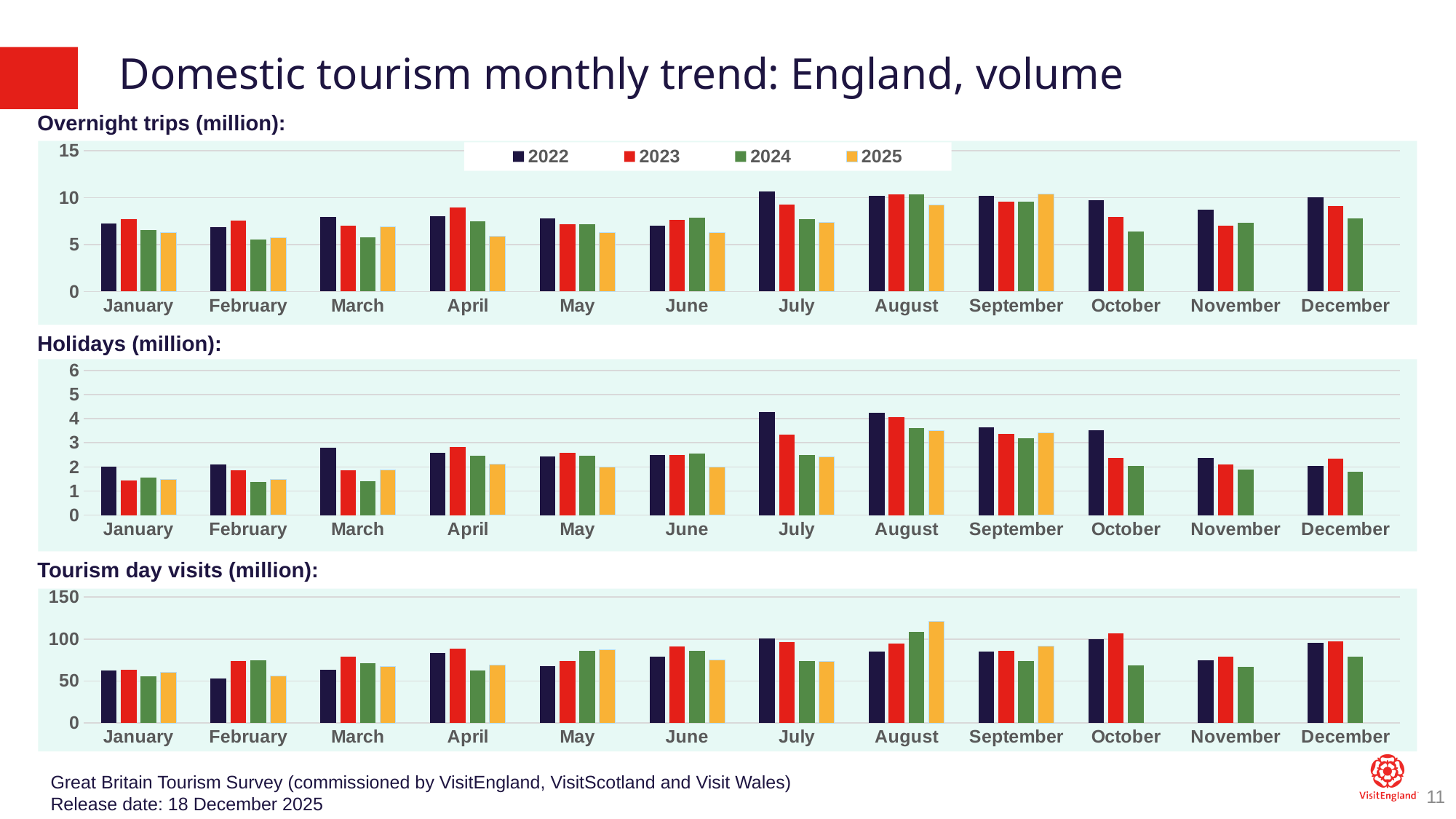
What kind of chart is the 'Overnight trips (million)' chart? bar chart In the 'Holidays (million)' chart, is the value for January 2023 greater or less than 2? less How many months are shown on the x axis of the 'Tourism day visits (million)' chart? 12 In the 'Holidays (million)' chart, which month has the highest value for 2023? August In the 'Overnight trips (million)' chart, which is larger for July: 2022 or 2023? 2022 In the 'Overnight trips (million)' chart, which month has the highest value for 2025? September How many series does the legend of the 'Overnight trips (million)' chart list? 4 In the 'Tourism day visits (million)' chart, which month has the highest value for 2025? August In the 'Tourism day visits (million)' chart, which is larger for October: 2023 or 2024? 2023 In the 'Overnight trips (million)' chart, is the value for July 2022 greater or less than 10? greater In the 'Holidays (million)' chart, do the 2022 values rise or fall from September to December? fall